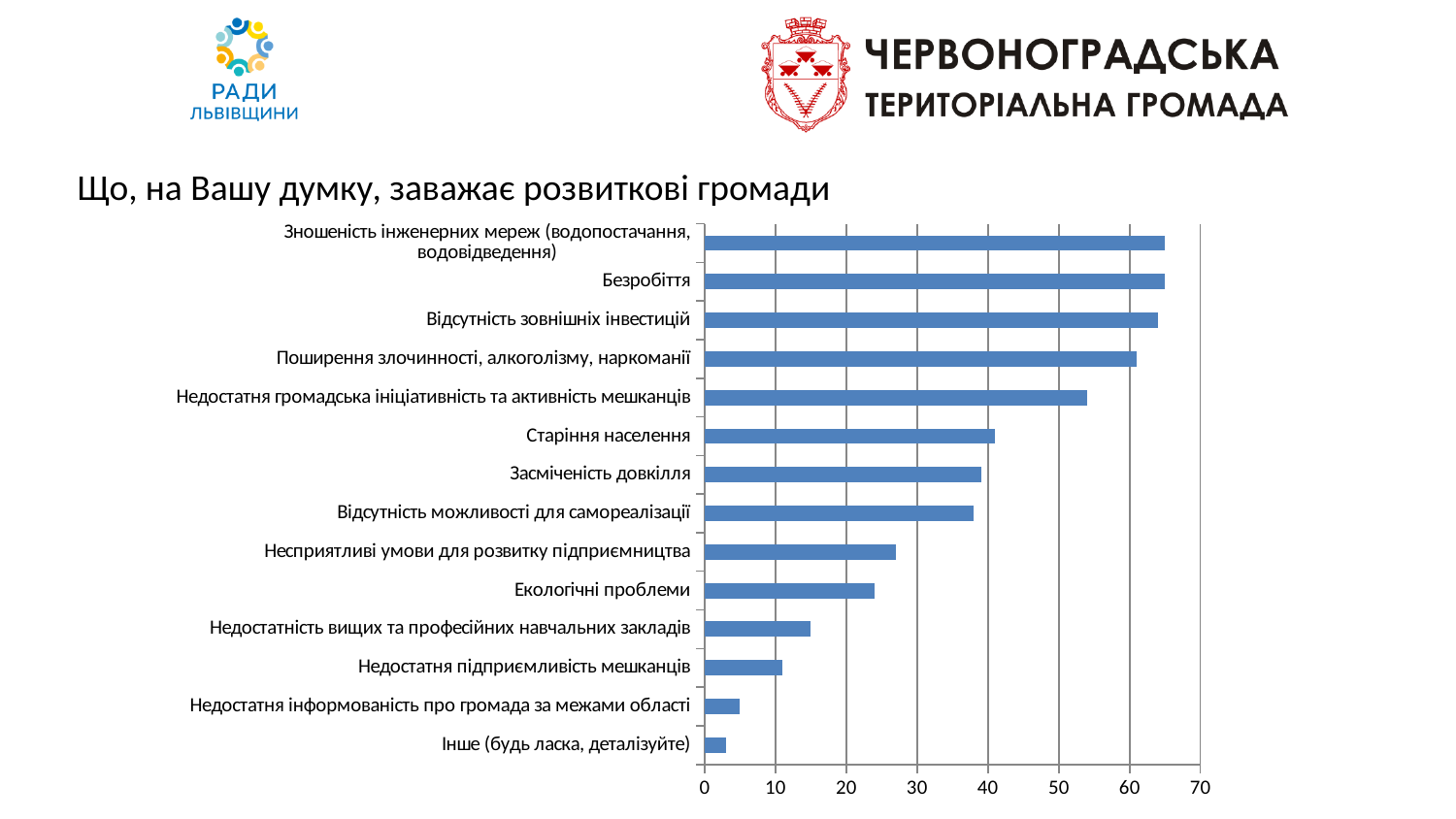
What kind of chart is shown on the slide? bar chart What is the title of the chart? Що, на Вашу думку, заважає розвиткові громади How many categories are plotted in the chart? 14 Is the value for "Недостатність вищих та професійних навчальних закладів" greater or less than 20? less Is the value for "Недостатня інформованість про громада за межами області" greater or less than 10? less Is the value for "Недостатня громадська ініціативність та активність мешканців" greater or less than 50? greater Which has a larger value: "Безробіття" or "Засміченість довкілля"? Безробіття What is the highest value shown on the horizontal axis? 70 Which has a larger value: "Старіння населення" or "Екологічні проблеми"? Старіння населення